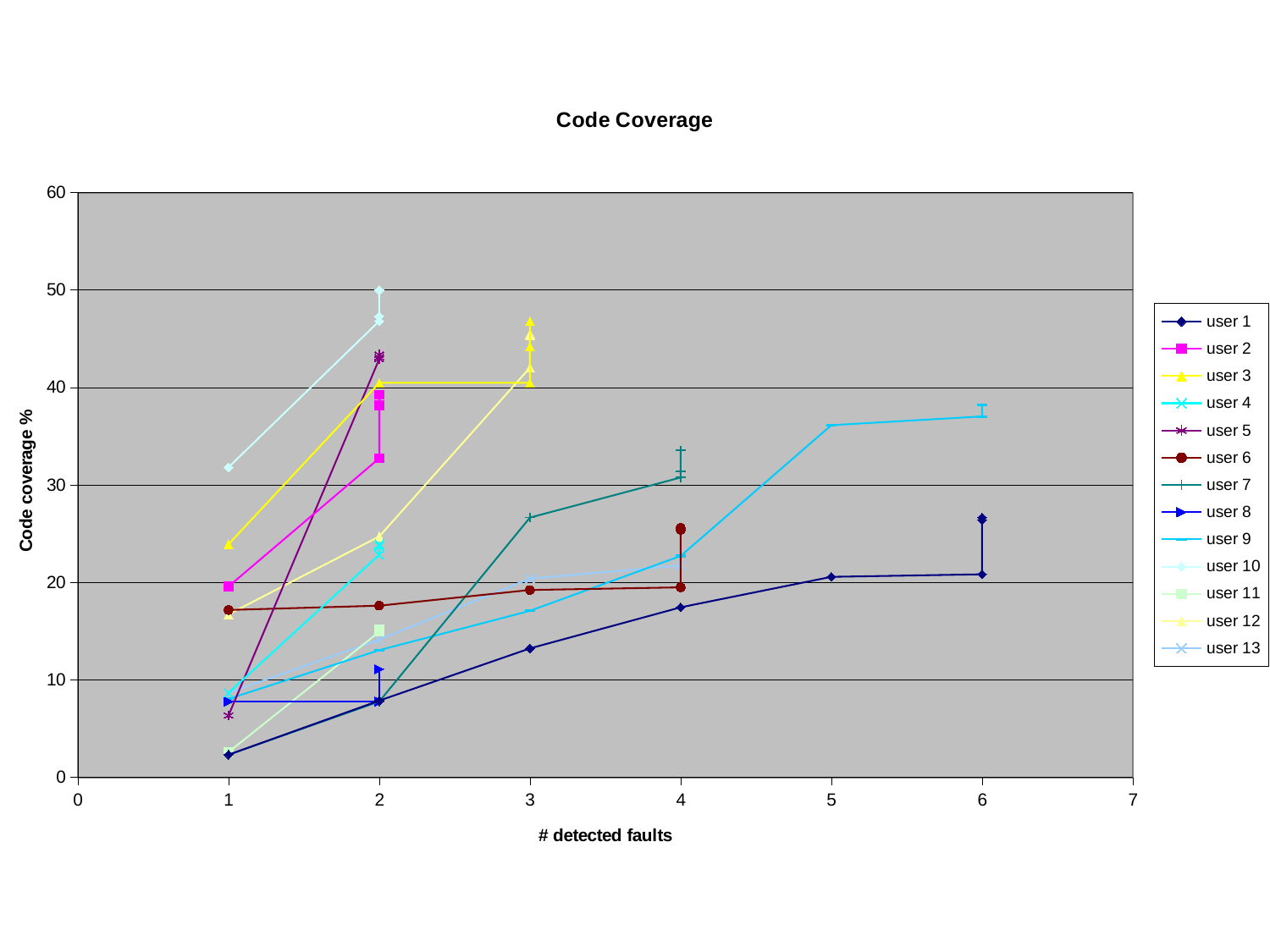
Is the value for user 12 at 3 detected faults greater or less than 40? greater What kind of chart is shown on the slide? line chart Is the value for user 1 at 1 detected fault greater or less than 10? less Is the value for user 10 at 1 detected fault greater or less than 30? greater What is the highest value shown on the y axis? 60 At 1 detected fault, which is larger: the value for user 10 or the value for user 3? user 10 Does the code coverage for user 1 rise or fall as the number of detected faults increases? rise What is the title of the chart? Code Coverage What is the label of the x axis? # detected faults How many series does the legend list? 13